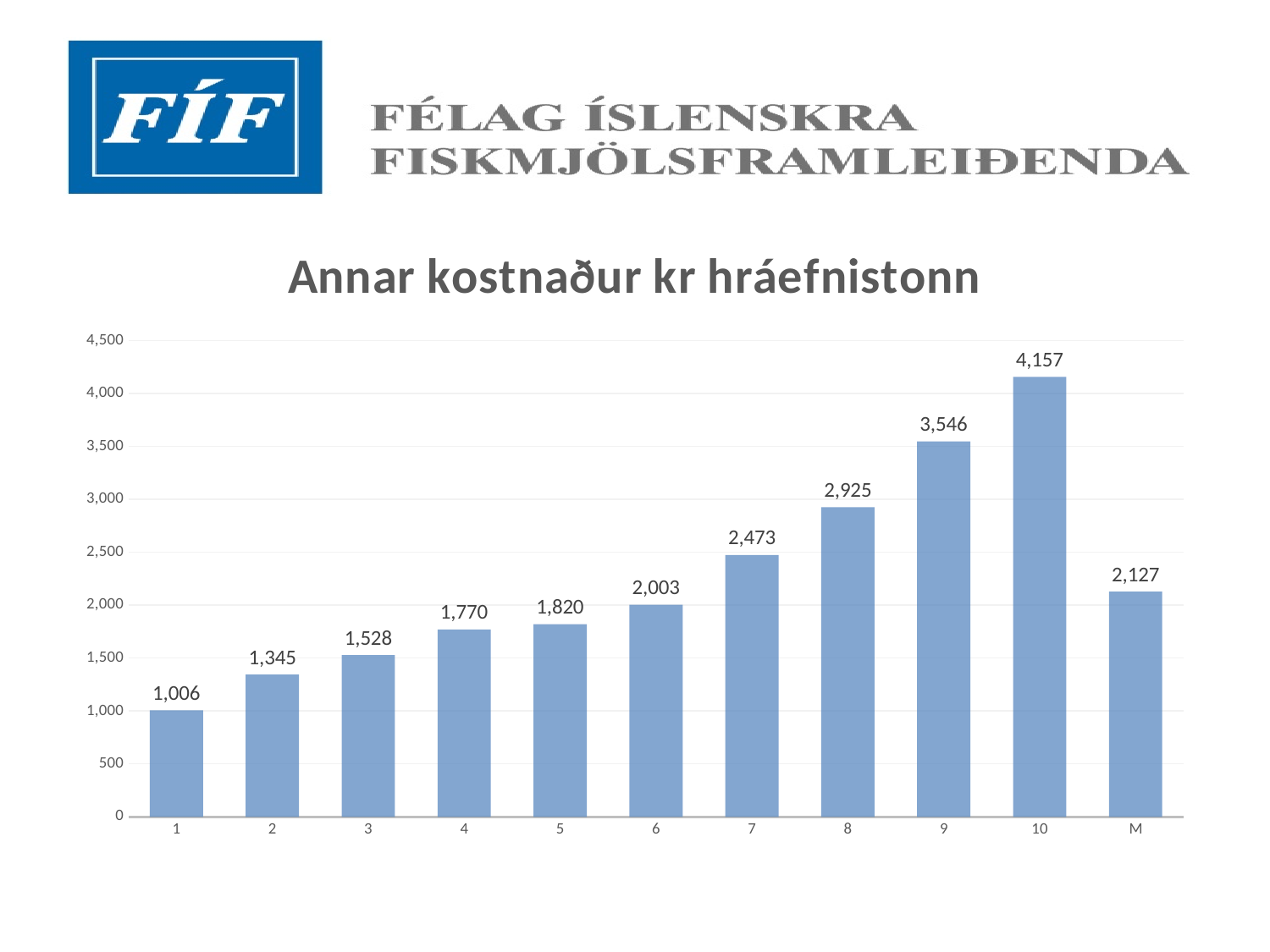
What is the value for category 1? 1,006 What is the title of the chart? Annar kostnaður kr hráefnistonn What is the difference between the values for category 10 and category 9? 611 What is the value for category M? 2,127 Do the values rise or fall from category 1 to category 10? rise Which is larger, the value for category 6 or the value for category M? M What is the value for category 10? 4,157 Is the value for category 8 greater or less than 3,000? less Which category has the lowest value? 1 What kind of chart is shown on the slide? bar chart Which category has the highest value? 10 How many bars are shown in the chart? 11